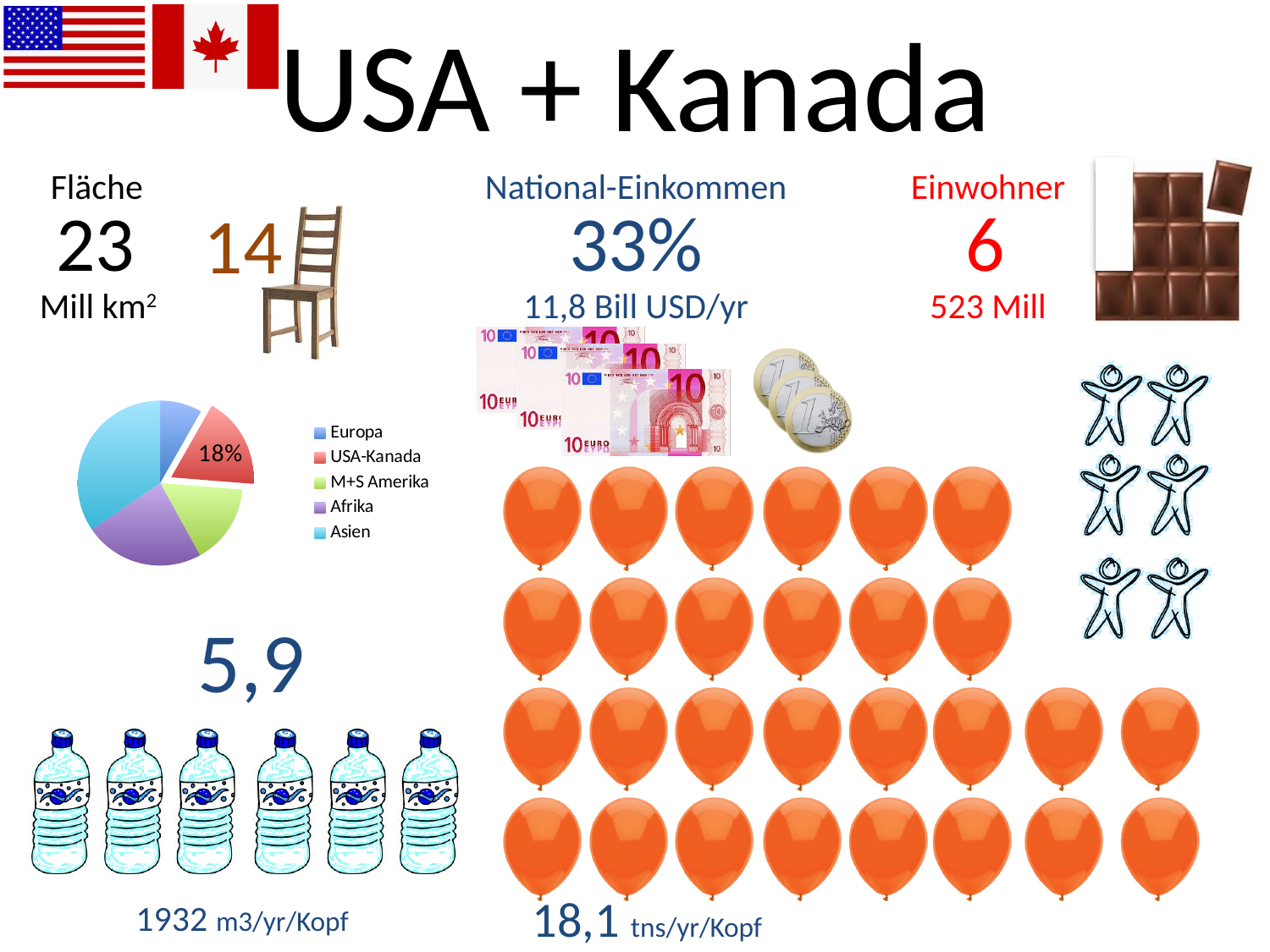
Which slice of the pie chart is pulled out from the rest? USA-Kanada How many categories does the pie chart's legend list? 5 Which slice is larger in the pie chart, Asien or USA-Kanada? Asien Which slice is larger in the pie chart, Afrika or Europa? Afrika Which category is listed first in the pie chart's legend? Europa Which category has the largest slice in the pie chart? Asien What share of the pie chart is labelled for USA-Kanada? 18% What kind of chart is shown on the left of the slide? pie chart Is the USA-Kanada slice of the pie chart greater or less than 25%? less What colour is the USA-Kanada slice in the pie chart? red